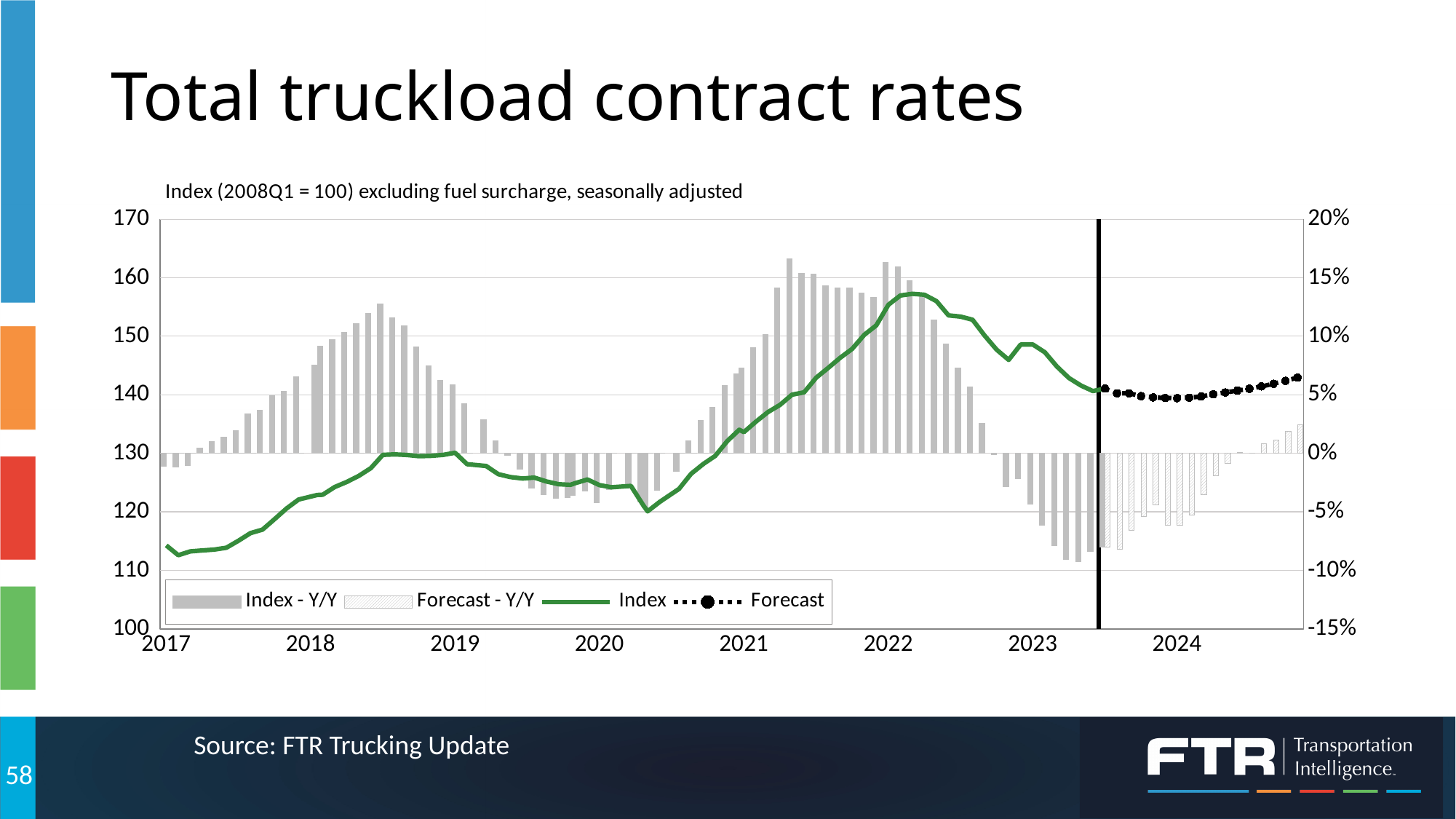
In which year does the Index line reach its highest point? 2022 What is the source cited for the chart? FTR Trucking Update What is the title of the chart on the slide? Index (2008Q1 = 100) excluding fuel surcharge, seasonally adjusted Is the peak Index value in 2022 greater or less than 150? greater How many series does the chart legend list? 4 Is the Index value at the start of 2017 greater or less than 120? less Is the Index value at the start of 2020 greater or less than 130? less Which is higher, the Index at the start of 2022 or the Index at the start of 2020? Start of 2022 What kind of chart is shown on the slide? Combination bar and line chart Does the Index line rise or fall from the start of 2017 to mid-2018? rise